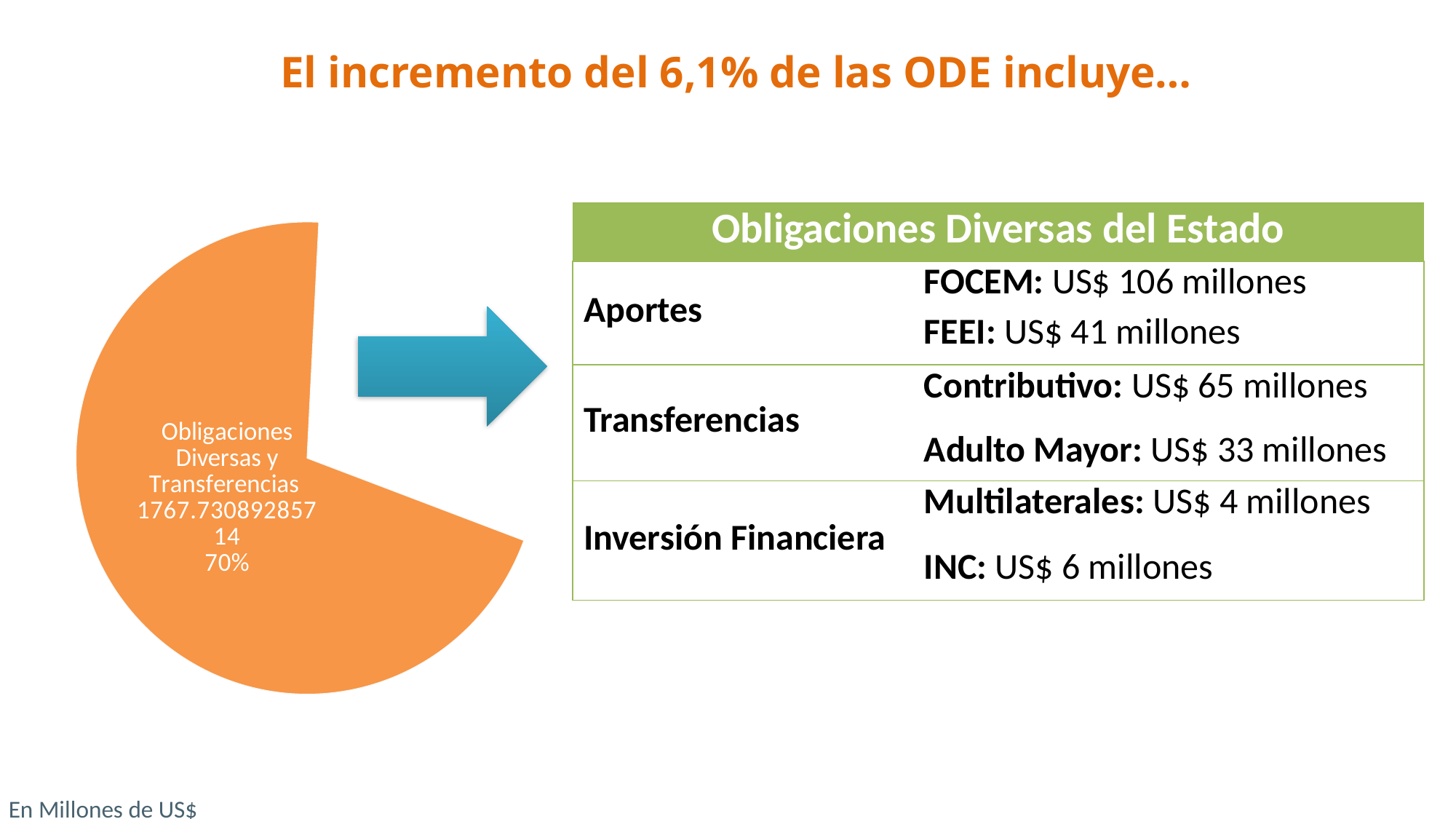
What share of the pie does the 'Obligaciones Diversas y Transferencias' slice represent? 70% What value is printed on the 'Obligaciones Diversas y Transferencias' slice of the pie chart? 1767.73089285714 Is the share of the 'Obligaciones Diversas y Transferencias' slice greater or less than 50%? greater What kind of chart is shown on the left of the slide? pie chart What colour is the 'Obligaciones Diversas y Transferencias' slice in the pie chart? orange What is the label of the slice shown in the pie chart? Obligaciones Diversas y Transferencias How many labelled slices are visible in the pie chart? 1